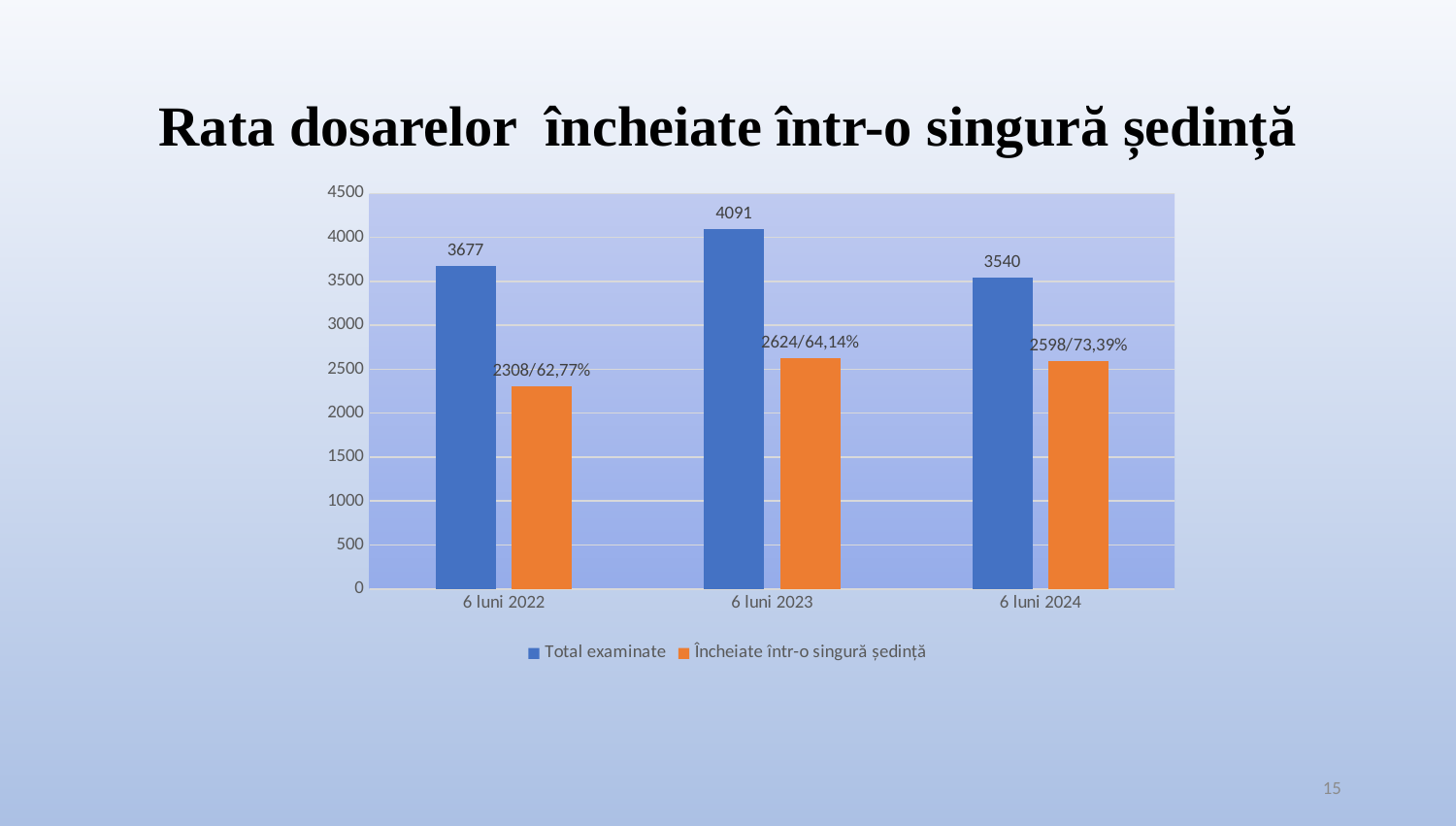
What data label is shown on the Încheiate într-o singură ședință bar for 6 luni 2022? 2308/62,77% What is the difference between Total examinate for 6 luni 2023 and 6 luni 2022? 414 What kind of chart is shown on the slide? bar chart Which is larger: Total examinate for 6 luni 2022 or for 6 luni 2024? 6 luni 2022 Is the Încheiate într-o singură ședință value for 6 luni 2023 greater or less than 2500? greater What is the value of Total examinate for 6 luni 2022? 3677 Which period has the highest Total examinate value? 6 luni 2023 How many series does the legend list? 2 Which period has the lowest Total examinate value? 6 luni 2024 What is the value of Total examinate for 6 luni 2023? 4091 How many periods are shown on the x axis? 3 What data label is shown on the Încheiate într-o singură ședință bar for 6 luni 2024? 2598/73,39%